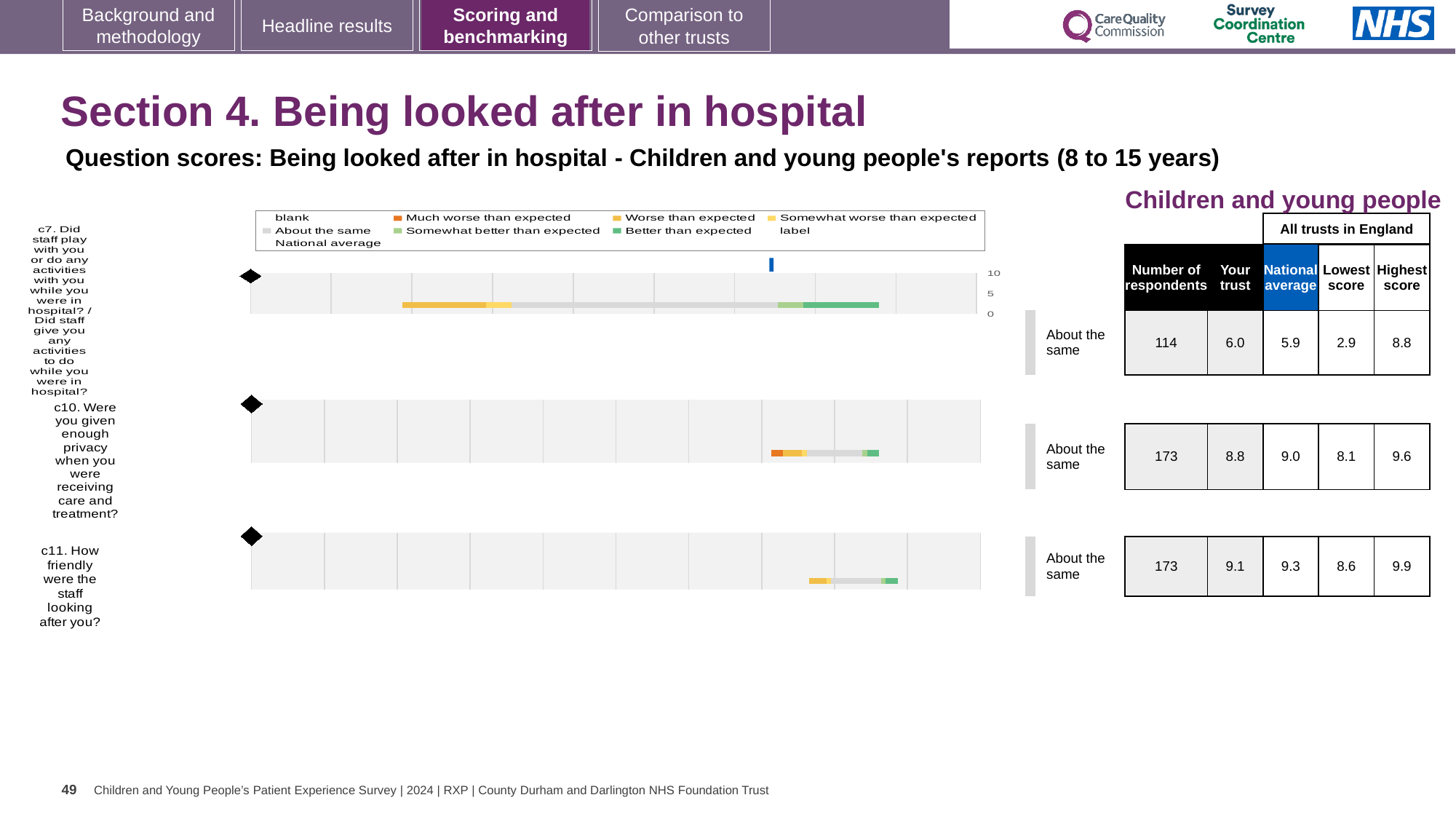
For question c10, which is larger: the 'Your trust' score or the national average? National average Which question has the highest 'Your trust' score? c11. How friendly were the staff looking after you? Which question has the lowest 'Lowest score' across all trusts in England? c7. Did staff play with you or do any activities with you while you were in hospital? What benchmark category is shown for question c7? About the same How many respondents answered question c10? 173 What kind of chart is used to show the benchmarking results for each question? Bar chart For question c11 (How friendly were the staff looking after you), what is the highest score among all trusts in England? 9.9 For question c7 (Did staff play with you or do any activities with you), what is the 'Your trust' score? 6.0 In the legend, what colour represents 'Better than expected'? Green For question c7, what is the difference between the highest score and the lowest score across all trusts in England? 5.9 How many survey questions are plotted in the benchmarking charts on this slide? 3 For question c10 (Were you given enough privacy), what is the national average score? 9.0